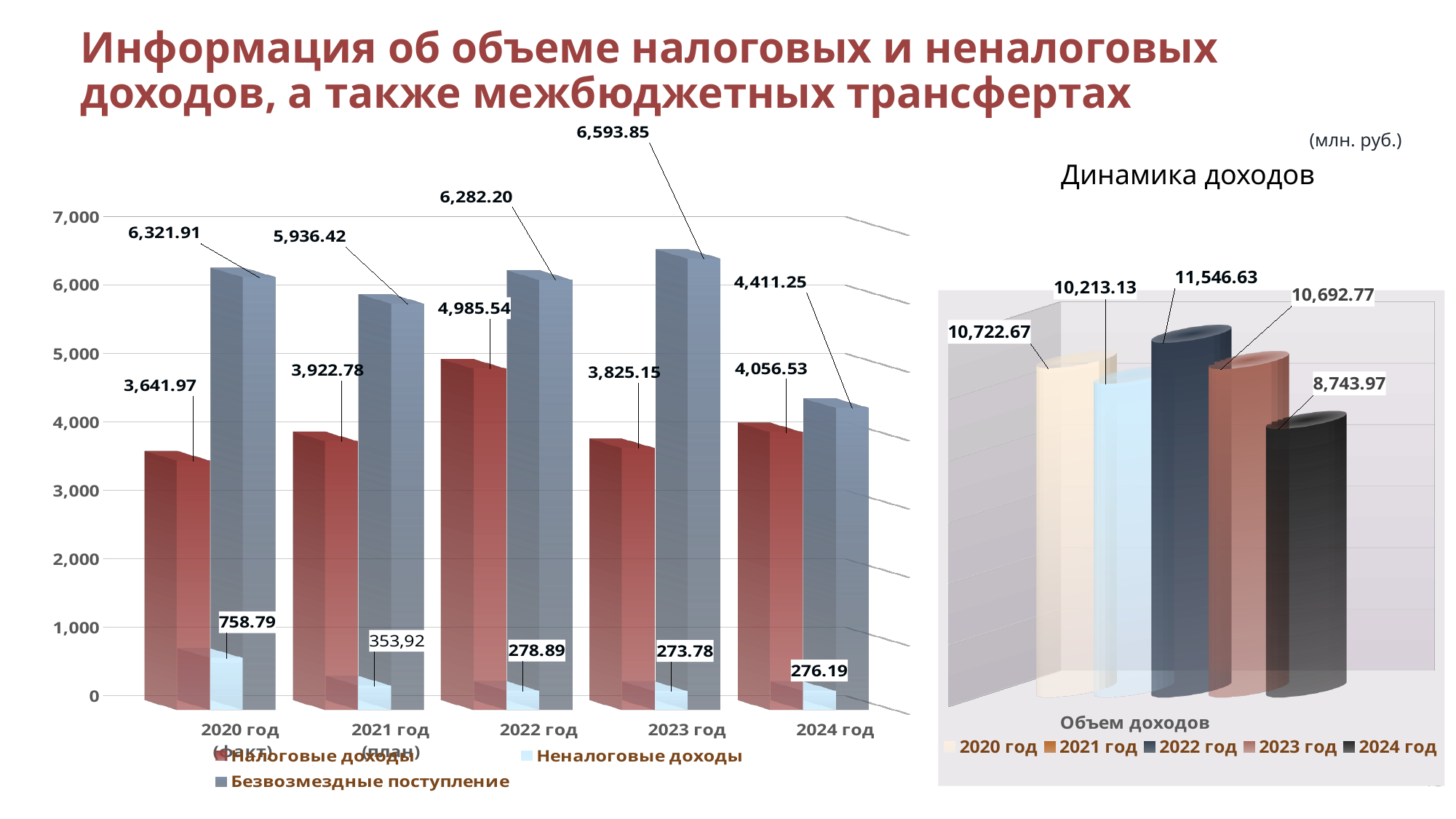
On the left chart, what is the value of Безвозмездные поступление for 2023 год? 6,593.85 On the left chart, which is larger in 2021 год: Налоговые доходы or Безвозмездные поступление? Безвозмездные поступление On the left chart, in which year is Безвозмездные поступление the lowest? 2024 год On the left chart, in which year is Налоговые доходы the highest? 2022 год On the left chart, what is the difference between Безвозмездные поступление and Налоговые доходы in 2024 год? 354.72 On the Динамика доходов chart, what is the value for 2022 год? 11,546.63 On the left chart, what is the value of Неналоговые доходы for 2020 год (факт)? 758.79 What kind of chart is the Динамика доходов chart? Bar chart On the left chart, what is the value of Налоговые доходы for 2022 год? 4,985.54 On the Динамика доходов chart, what is the difference between 2020 год and 2024 год? 1,978.70 On the Динамика доходов chart, which year has the lowest value? 2024 год How many series does the legend of the left chart list? 3